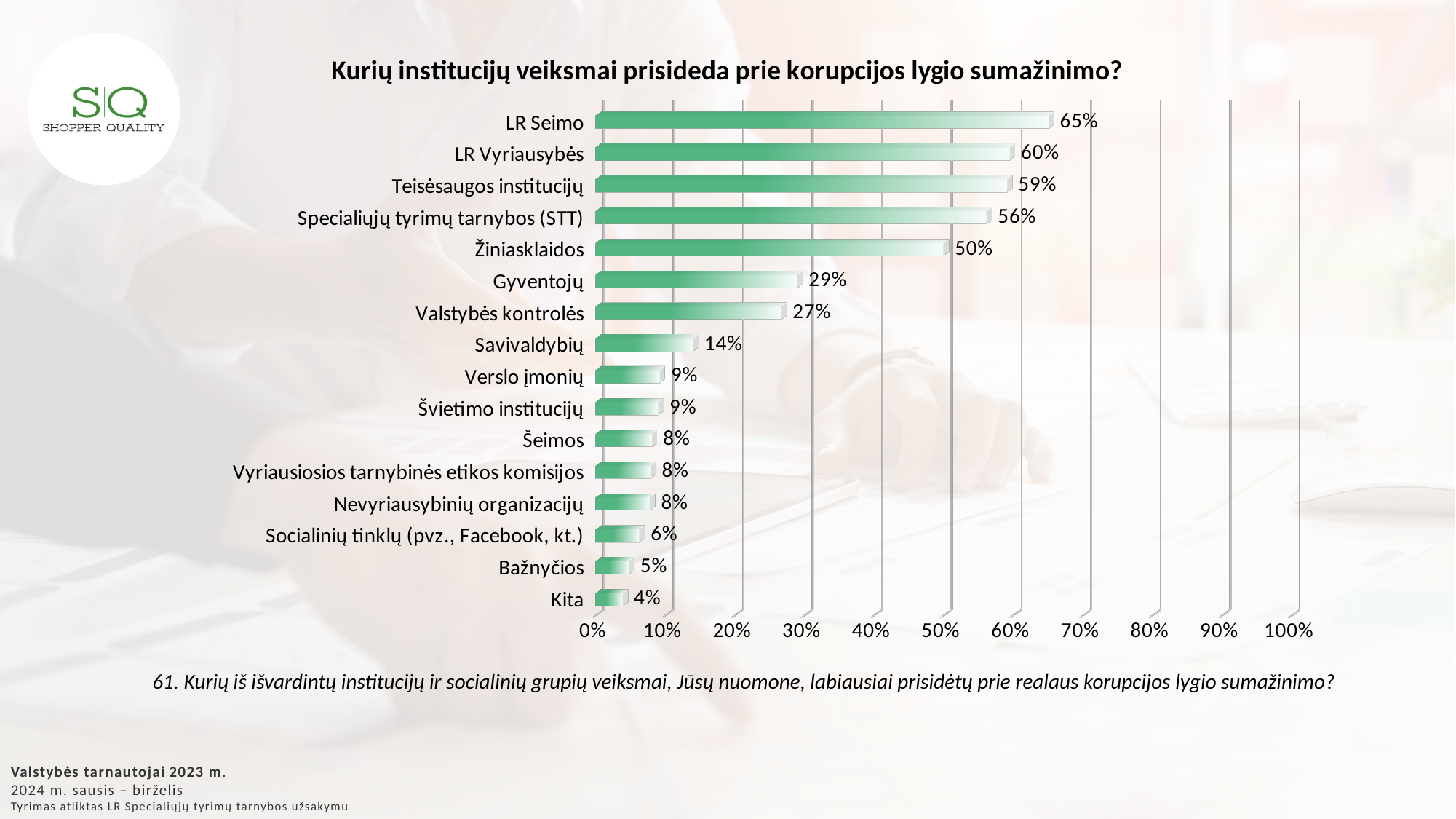
What is the value for Bažnyčios? 5% How many categories are shown in the chart? 16 Which category has the lowest value? Kita What is the value for LR Seimo? 65% What is the value for Valstybės kontrolės? 27% What is the value for Žiniasklaidos? 50% What is the title of the chart? Kurių institucijų veiksmai prisideda prie korupcijos lygio sumažinimo? What is the difference between the values for LR Seimo and LR Vyriausybės? 5% What kind of chart is shown on the slide? Bar chart What is the difference between the values for Gyventojų and Savivaldybių? 15% Which category has the highest value? LR Seimo Which is larger, the value for Specialiųjų tyrimų tarnybos (STT) or the value for Žiniasklaidos? Specialiųjų tyrimų tarnybos (STT)